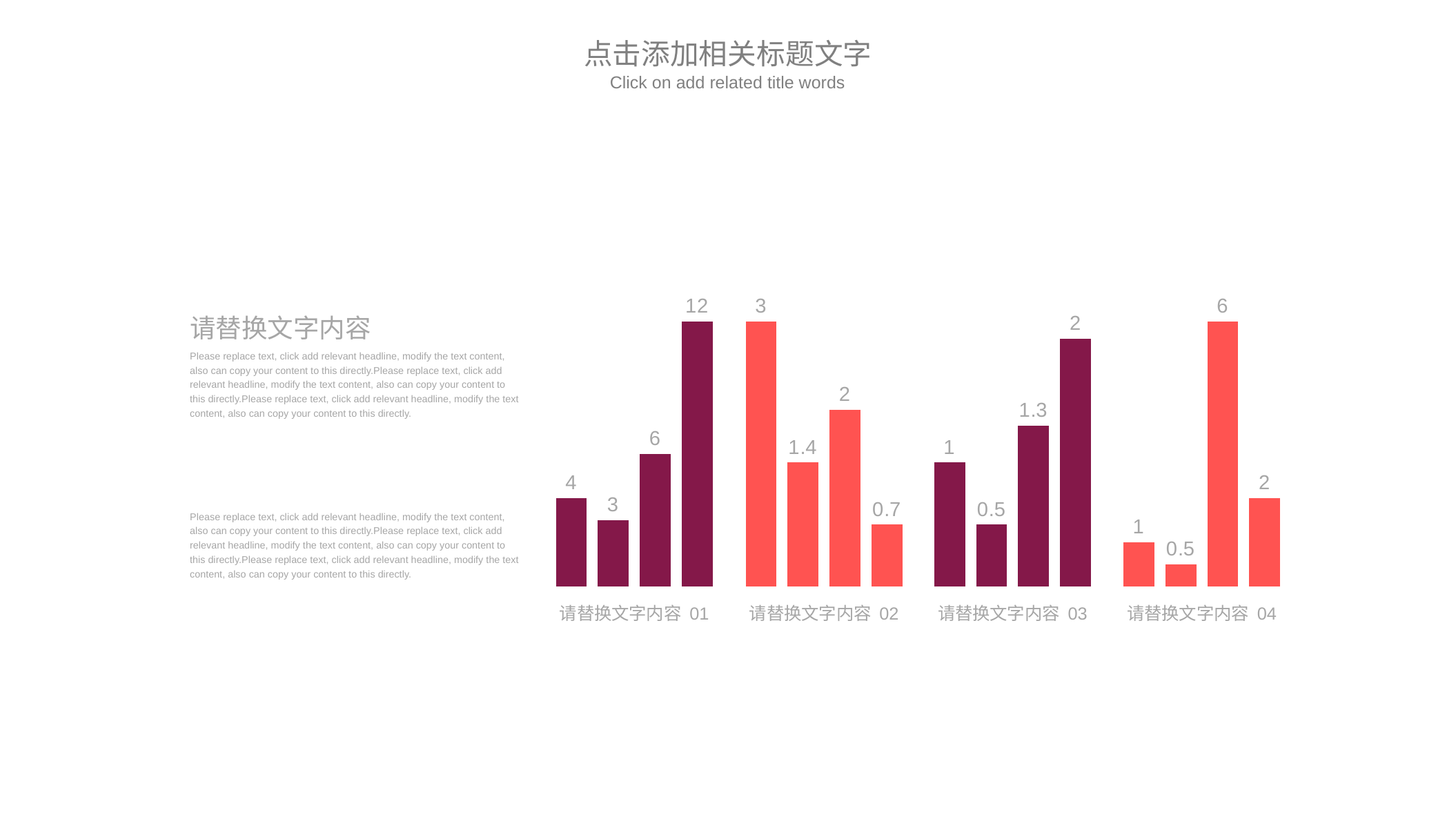
How many bars are in each category group? 4 Which is larger: the first bar of 请替换文字内容 01 or the first bar of 请替换文字内容 02? the first bar of 请替换文字内容 01 What is the value of the first bar in the group labelled 请替换文字内容 02? 3 What is the value of the tallest bar in the group labelled 请替换文字内容 04? 6 What is the value of the tallest bar in the group labelled 请替换文字内容 01? 12 What is the value of the last bar in the group labelled 请替换文字内容 02? 0.7 What is the lowest value in the group labelled 请替换文字内容 02? 0.7 Which category group contains the highest bar in the whole chart? 请替换文字内容 01 What is the difference between the tallest bar (12) and the third bar (6) in the group labelled 请替换文字内容 01? 6 How many labelled category groups are shown along the bottom of the chart? 4 What type of chart is shown on the slide? bar chart What is the value of the third bar in the group labelled 请替换文字内容 03? 1.3